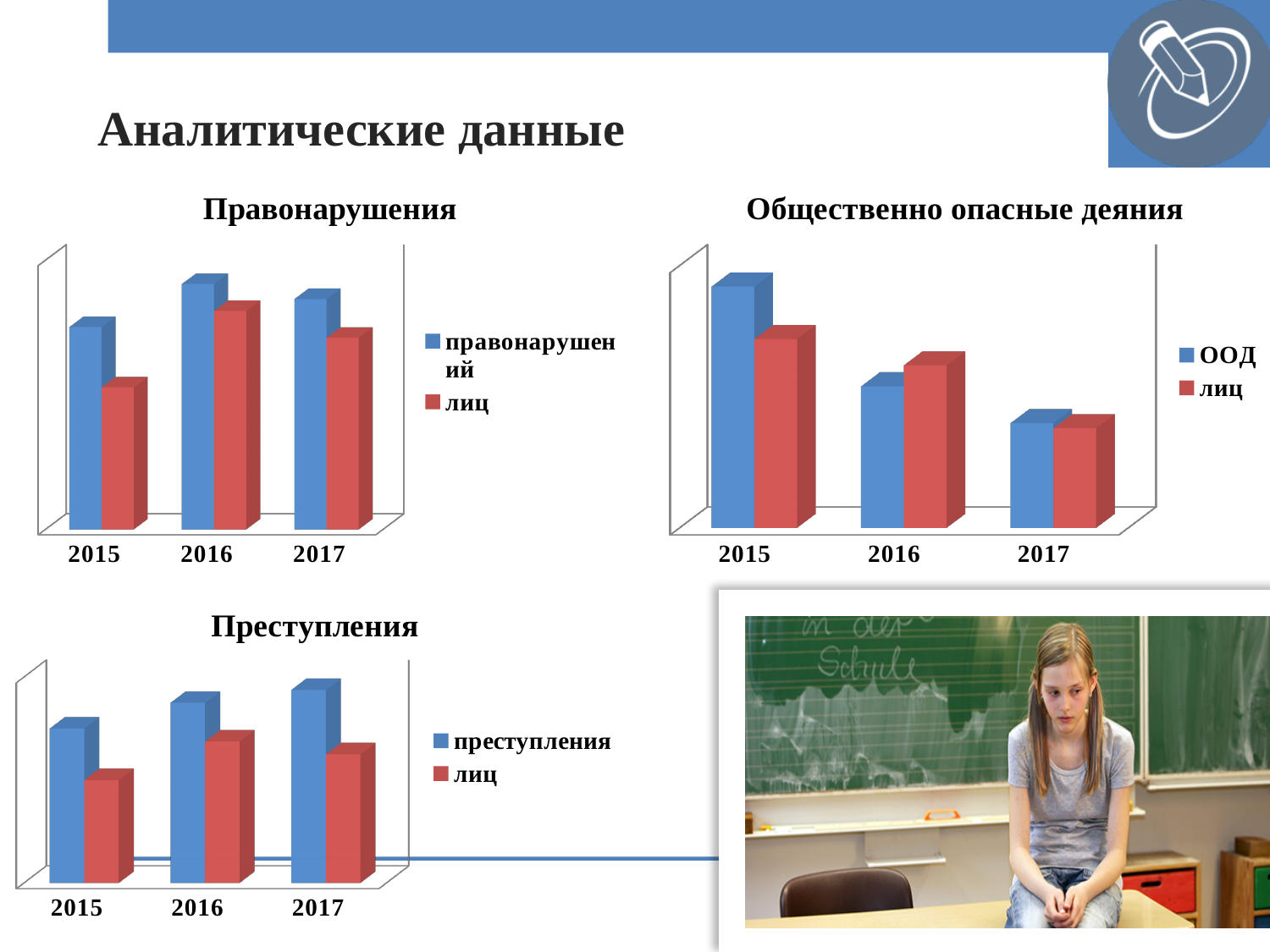
In the "Преступления" chart, do the values for "преступления" rise or fall from 2015 to 2017? rise In the "Правонарушения" chart, which year has the highest value for "правонарушений"? 2016 What kind of chart is the "Правонарушения" chart? bar chart In the "Правонарушения" chart, which is larger in 2015: "правонарушений" or "лиц"? правонарушений In the "Общественно опасные деяния" chart, which is larger in 2016: "ООД" or "лиц"? лиц In the "Общественно опасные деяния" chart, do the values for "ООД" rise or fall from 2015 to 2017? fall What are the two legend entries of the "Общественно опасные деяния" chart? ООД, лиц In the "Правонарушения" chart, which year has the lowest value for "лиц"? 2015 In the "Общественно опасные деяния" chart, which year has the highest value for "лиц"? 2015 How many series does the legend of the "Правонарушения" chart list? 2 How many years are shown on the x axis of the "Общественно опасные деяния" chart? 3 In the "Преступления" chart, which year has the lowest value for "лиц"? 2015